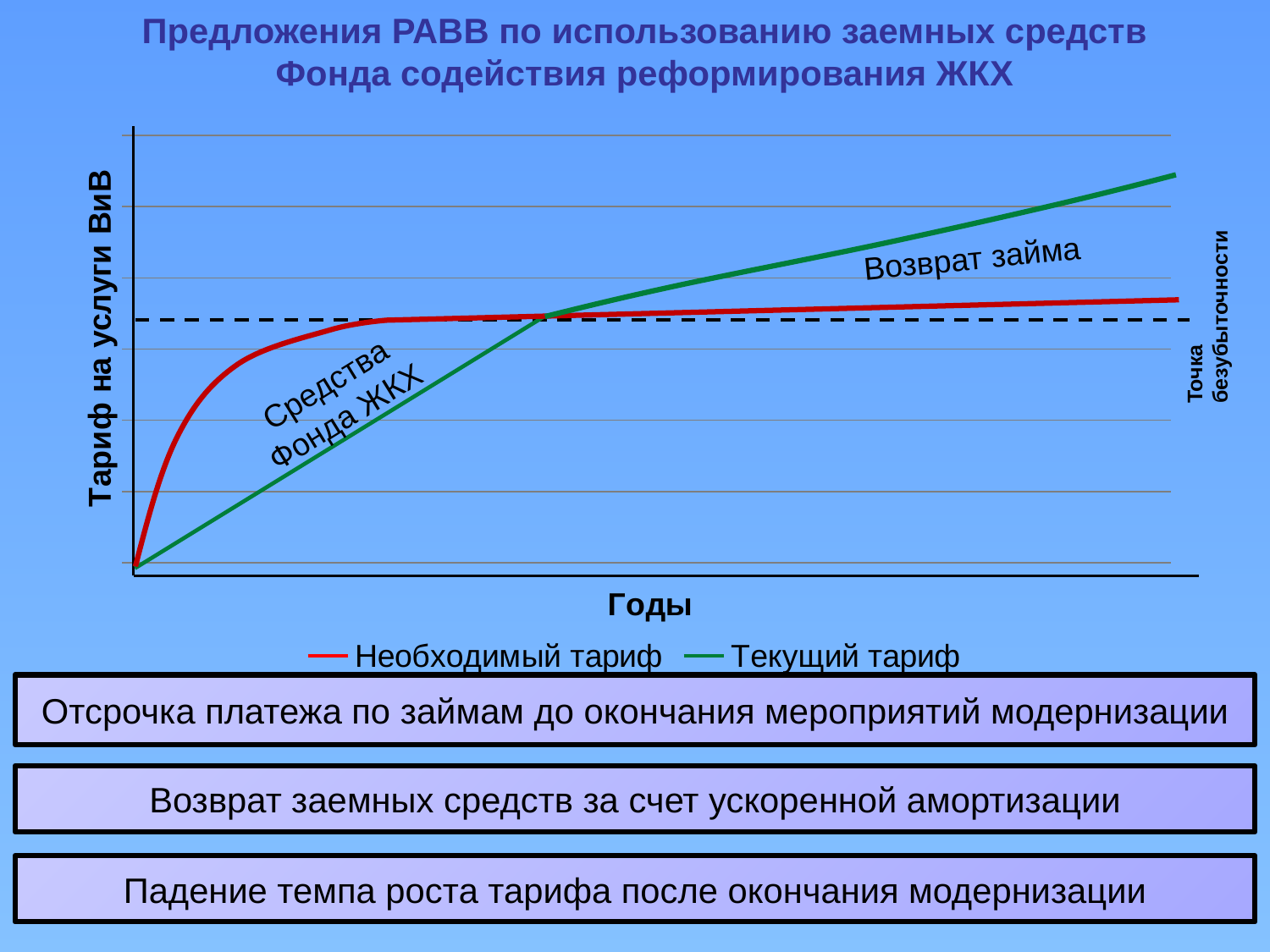
Which colour is used for the series "Текущий тариф"? green Does the "Необходимый тариф" line rise or fall along the x axis? rises What are the two series named in the chart legend? Необходимый тариф, Текущий тариф How many series does the chart legend list? 2 What kind of chart is shown on the slide? line chart In the early years on the left side of the chart, which series is higher: "Необходимый тариф" or "Текущий тариф"? Необходимый тариф At the right end of the chart, which series is higher: "Необходимый тариф" or "Текущий тариф"? Текущий тариф What is the label of the horizontal (x) axis of the chart? Годы Does the "Текущий тариф" line rise or fall along the x axis? rises